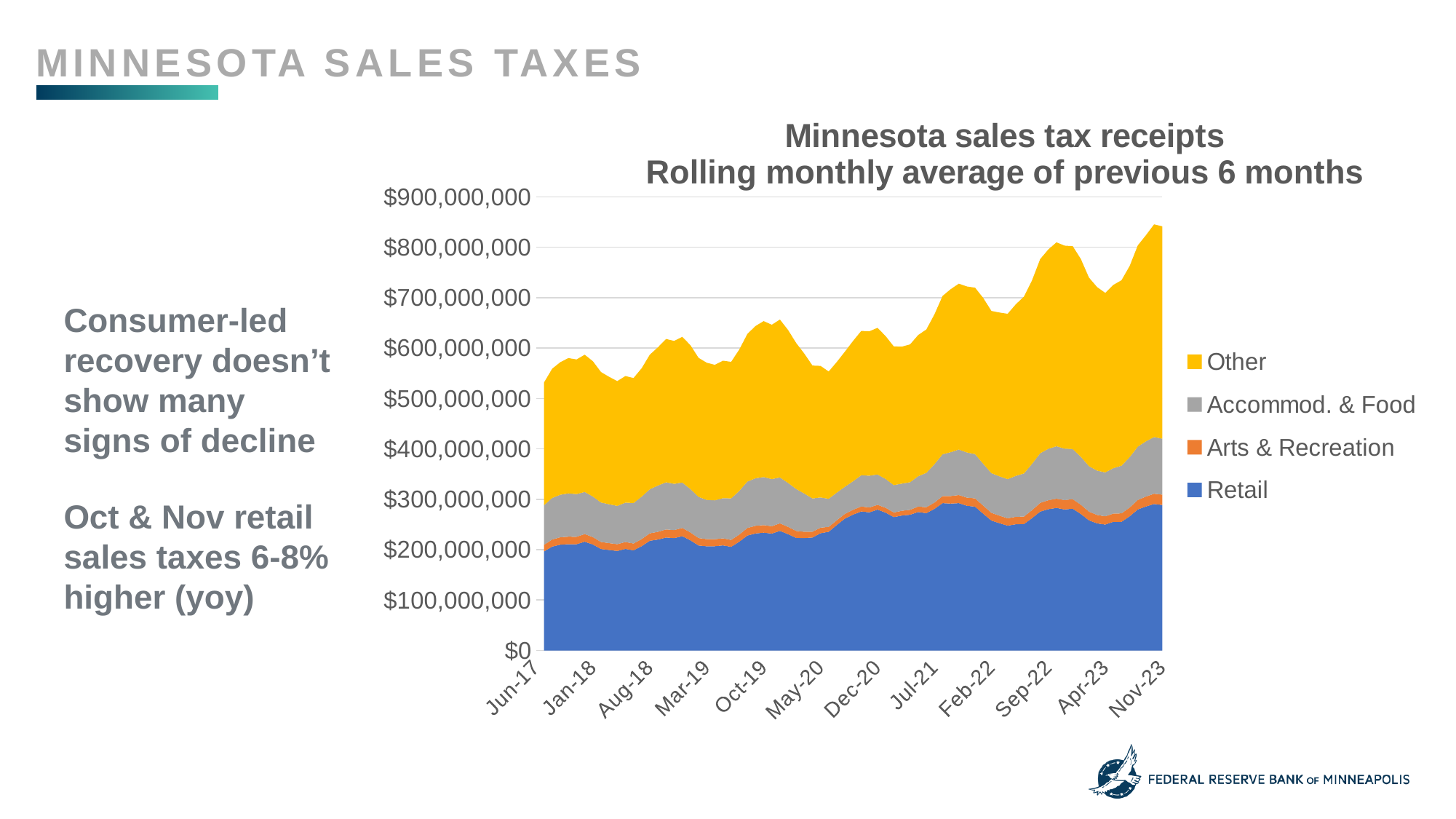
What is the title of the chart? Minnesota sales tax receipts Rolling monthly average of previous 6 months Which series contributes the smallest amount to the stacked total? Arts & Recreation Is the total value at Feb-22 greater or less than $600,000,000? greater Which is larger at Nov-23, the Retail value or the Arts & Recreation value? Retail How many series does the chart legend list? 4 Is the total value at Nov-23 greater or less than $800,000,000? greater Is the Retail value at Nov-23 greater or less than $200,000,000? greater Does the total of sales tax receipts generally rise or fall from Jun-17 to Nov-23? rise Which series are listed in the chart legend? Other, Accommod. & Food, Arts & Recreation, Retail What kind of chart is shown on the slide? Stacked area chart